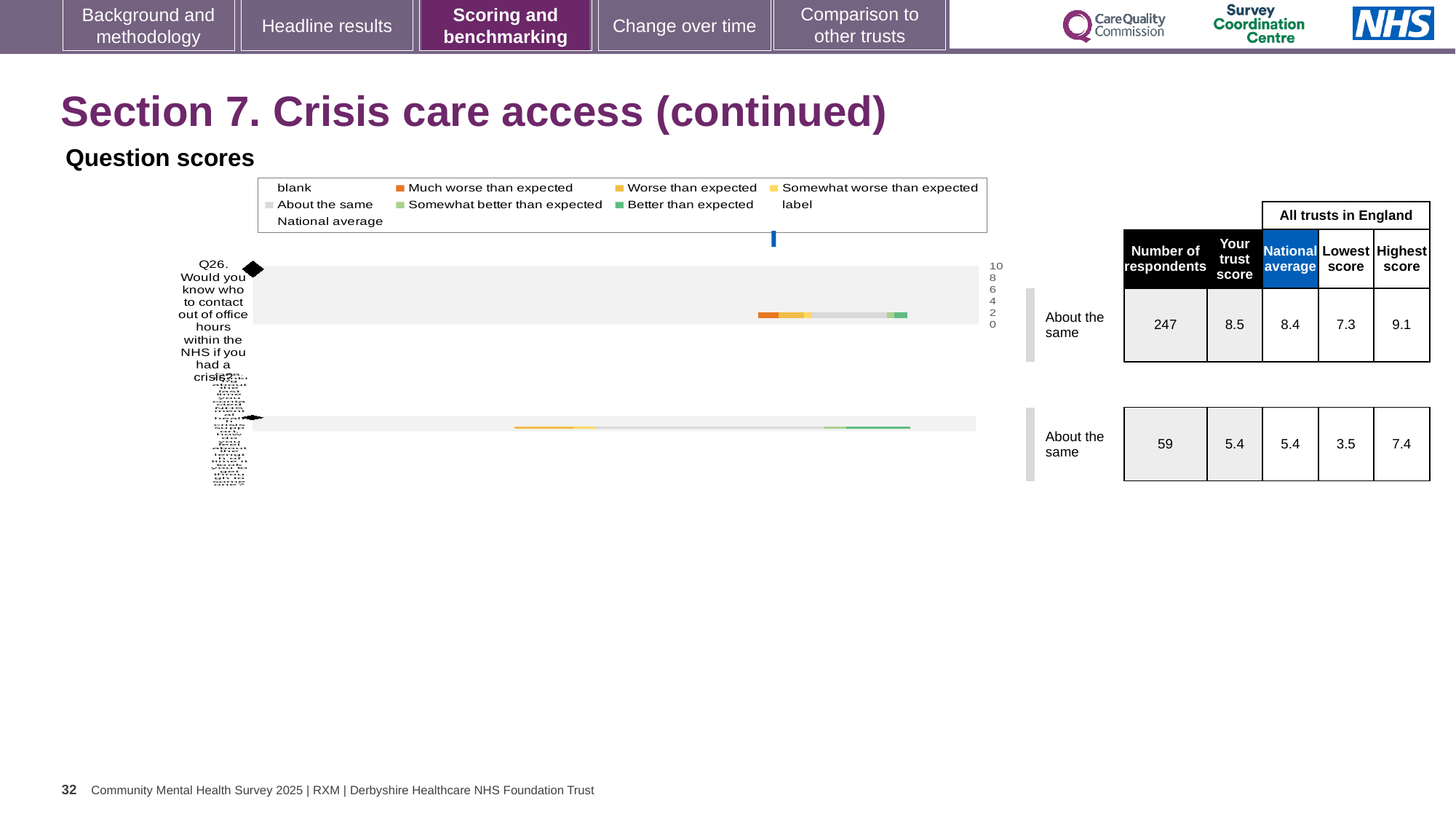
In the table beside the chart, what is the number of respondents for Q26? 247 What is the highest value shown on the chart's axis? 10 What kind of chart is shown under 'Question scores'? bar chart How many question bars are plotted in the chart? 2 Which colour does the legend use for 'Much worse than expected'? orange For Q26, is 'Your trust score' larger or smaller than the national average? larger In the table beside the chart, what is the national average for Q26? 8.4 For Q26, what is the difference between the highest score and the lowest score in the table? 1.8 In the table beside the chart, what is 'Your trust score' for Q26? 8.5 In the table beside the chart, what is the highest score for Q26? 9.1 What benchmark category is shown for Q26 next to the chart? About the same In the table beside the chart, what is the lowest score for Q26? 7.3